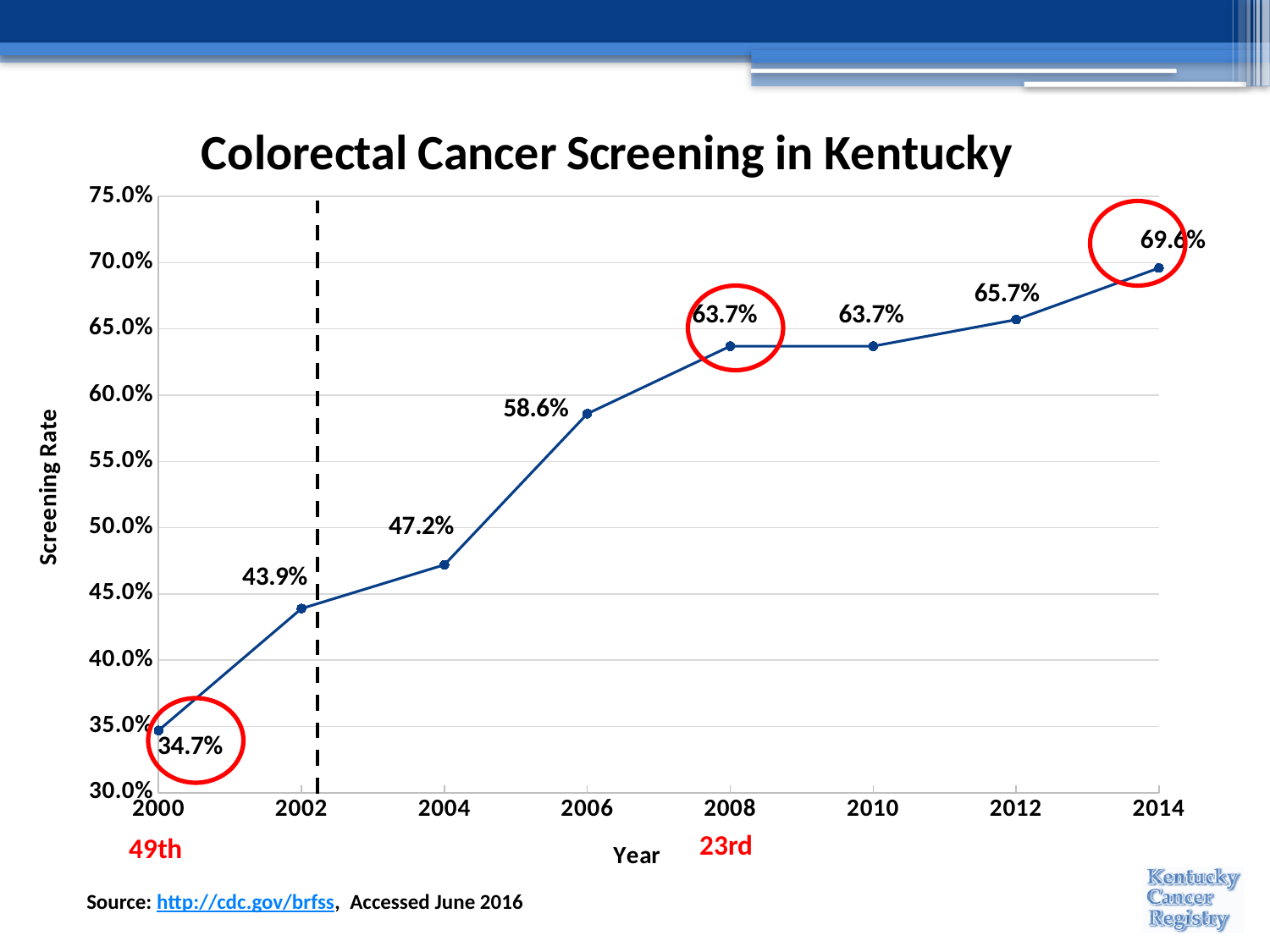
Do the screening rates generally rise or fall from 2000 to 2014? Rise What is the difference between the screening rates in 2006 and 2004? 11.4% How many data points are plotted on the chart? 8 What type of chart is shown on the slide? Line chart What was the screening rate in 2014? 69.6% What is the difference between the screening rates in 2014 and 2000? 34.9% What was the colorectal cancer screening rate in Kentucky in 2000? 34.7% Which year has the highest screening rate? 2014 What is the title of the chart? Colorectal Cancer Screening in Kentucky Which year has the lowest screening rate? 2000 Which year had a higher screening rate, 2002 or 2004? 2004 What was the screening rate in 2006? 58.6%